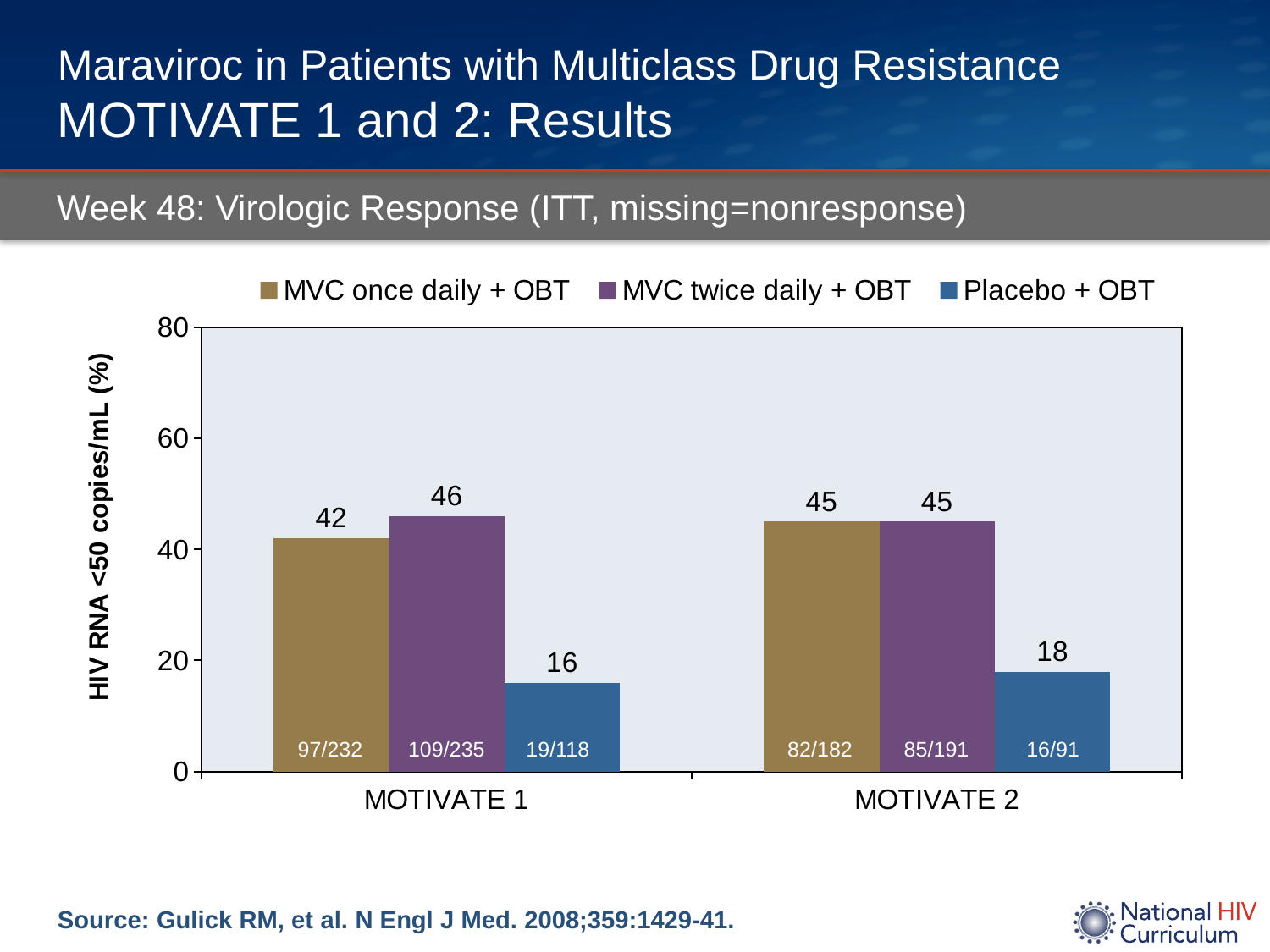
Which series has the lowest value in MOTIVATE 1? Placebo + OBT What kind of chart is shown? Bar chart What is the y-axis label of the chart? HIV RNA <50 copies/mL (%) What is the value for Placebo + OBT in MOTIVATE 2? 18 What is the difference between MVC once daily + OBT and Placebo + OBT in MOTIVATE 2? 27 How many series does the legend list? 3 What is the value for MVC twice daily + OBT in MOTIVATE 1? 46 What is the difference between MVC twice daily + OBT and Placebo + OBT in MOTIVATE 1? 30 Which series has the highest value in MOTIVATE 1? MVC twice daily + OBT How many categories are shown on the x axis? 2 Which is larger: MVC once daily + OBT in MOTIVATE 1 or MVC once daily + OBT in MOTIVATE 2? MOTIVATE 2 What is the value for MVC once daily + OBT in MOTIVATE 1? 42